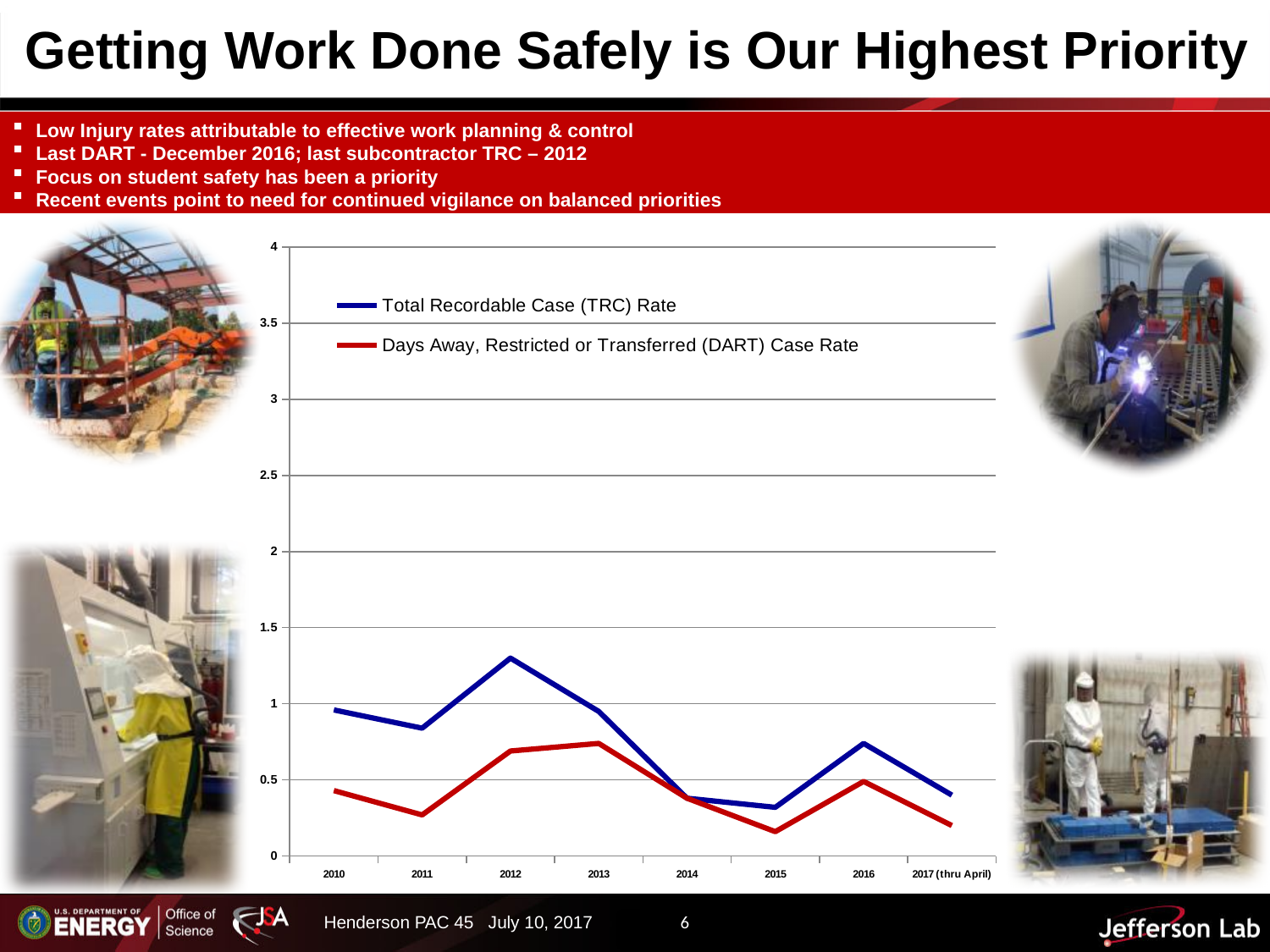
How many series does the chart legend list? 2 Is the DART Case Rate for 2012 greater or less than 0.5? greater Is the Total Recordable Case (TRC) Rate for 2012 greater or less than 1? greater How many years (x-axis categories) are plotted on the chart? 8 In 2012, which is larger: the TRC Rate or the DART Case Rate? TRC Rate In which year is the Total Recordable Case (TRC) Rate lowest? 2015 What colour is the line for the Days Away, Restricted or Transferred (DART) Case Rate? red Is the Total Recordable Case (TRC) Rate for 2015 greater or less than 0.5? less Does the Total Recordable Case (TRC) Rate rise or fall from 2013 to 2015? fall What kind of chart is shown on the slide? line chart In which year is the Total Recordable Case (TRC) Rate highest? 2012